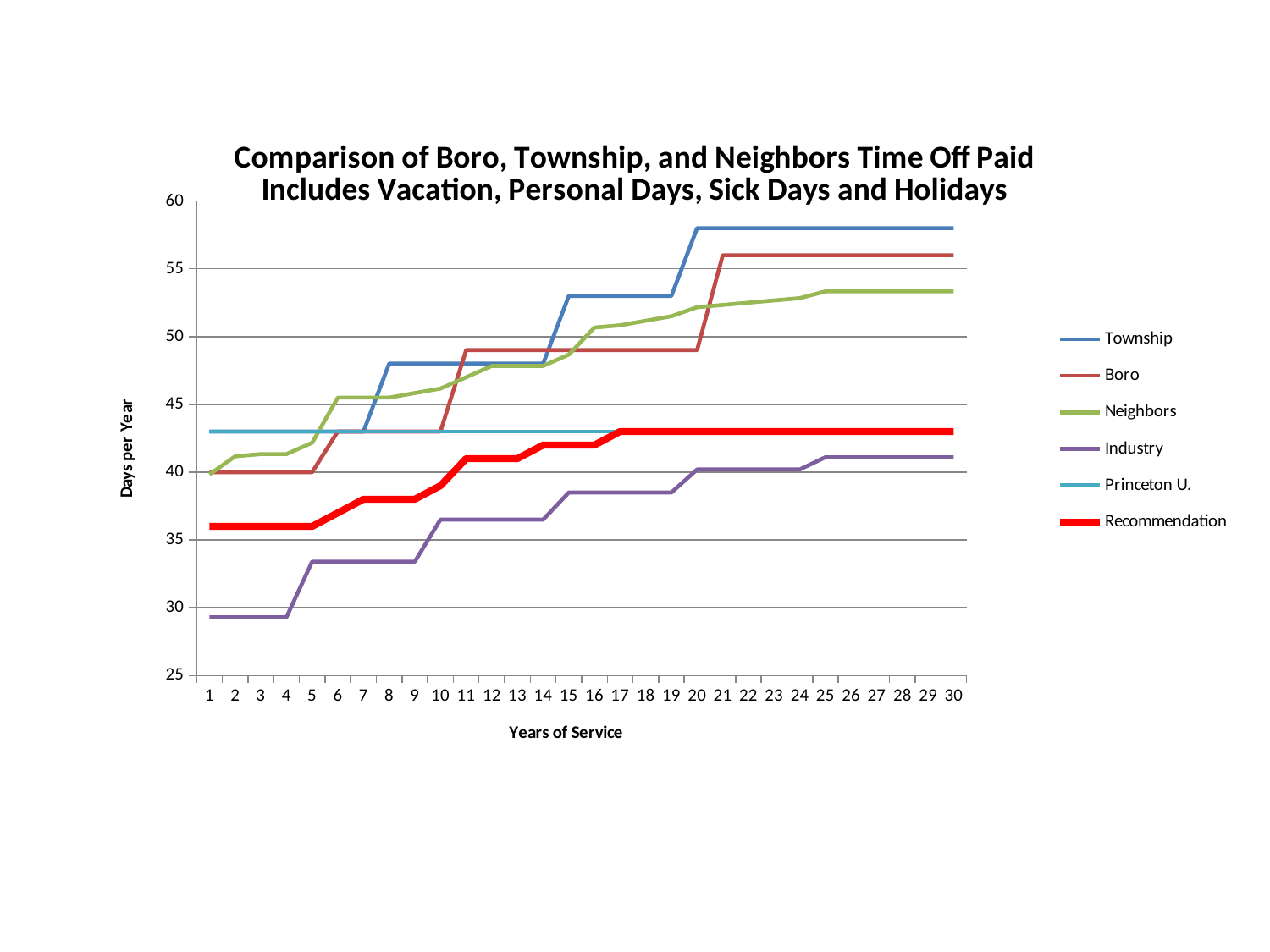
Is the Industry value at 1 year of service greater or less than 30? less Which series has the highest value at 30 years of service? Township Does the Township series rise or fall as years of service increase? rise Which series has the lowest value at 30 years of service? Industry Is the Recommendation value at 30 years of service greater or less than 45? less Which series is drawn as a thick red line? Recommendation How many series does the legend list? 6 How many years of service are plotted along the x axis? 30 At 30 years of service, which is larger, Township or Boro? Township Is the Township value at 30 years of service greater or less than 55? greater What kind of chart is shown on the slide? line chart